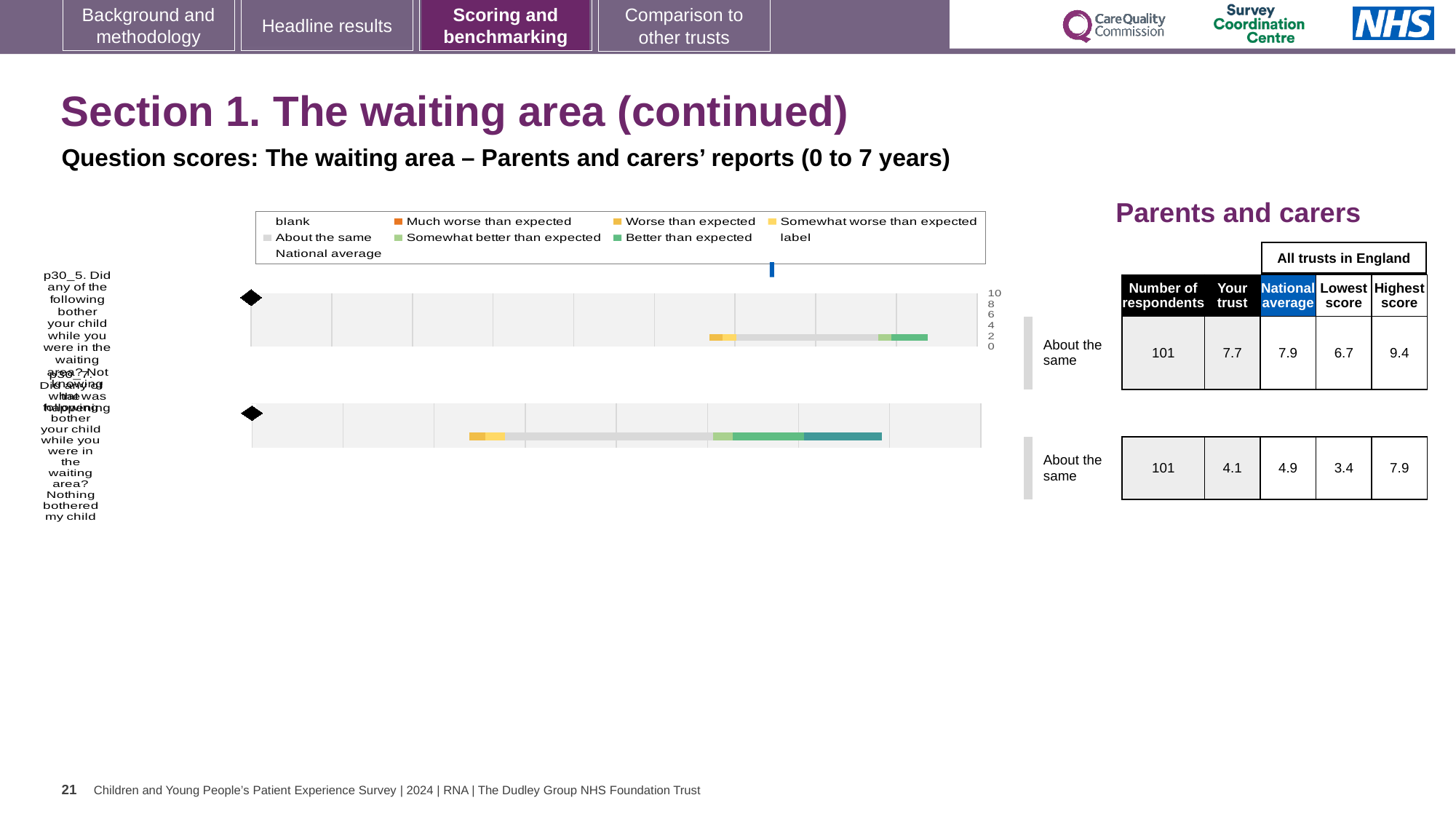
What is the highest score across all trusts in England for question p30_5? 9.4 Which legend entry is shown in orange? Much worse than expected What is the difference between the highest and lowest scores across all trusts for question p30_7? 4.5 What is the 'Your trust' score for question p30_7 (Nothing bothered my child)? 4.1 What kind of chart is shown on the slide? bar chart How many question bars are plotted in the chart? 2 What is the 'Your trust' score for question p30_5 (Not knowing what was happening)? 7.7 How many entries does the chart legend list? 9 Which question has the larger 'Your trust' score, p30_5 or p30_7? p30_5 What is the difference between the national average and the 'Your trust' score for question p30_5? 0.2 What is the national average score for question p30_7? 4.9 What is the subtitle above the chart? Question scores: The waiting area – Parents and carers’ reports (0 to 7 years)